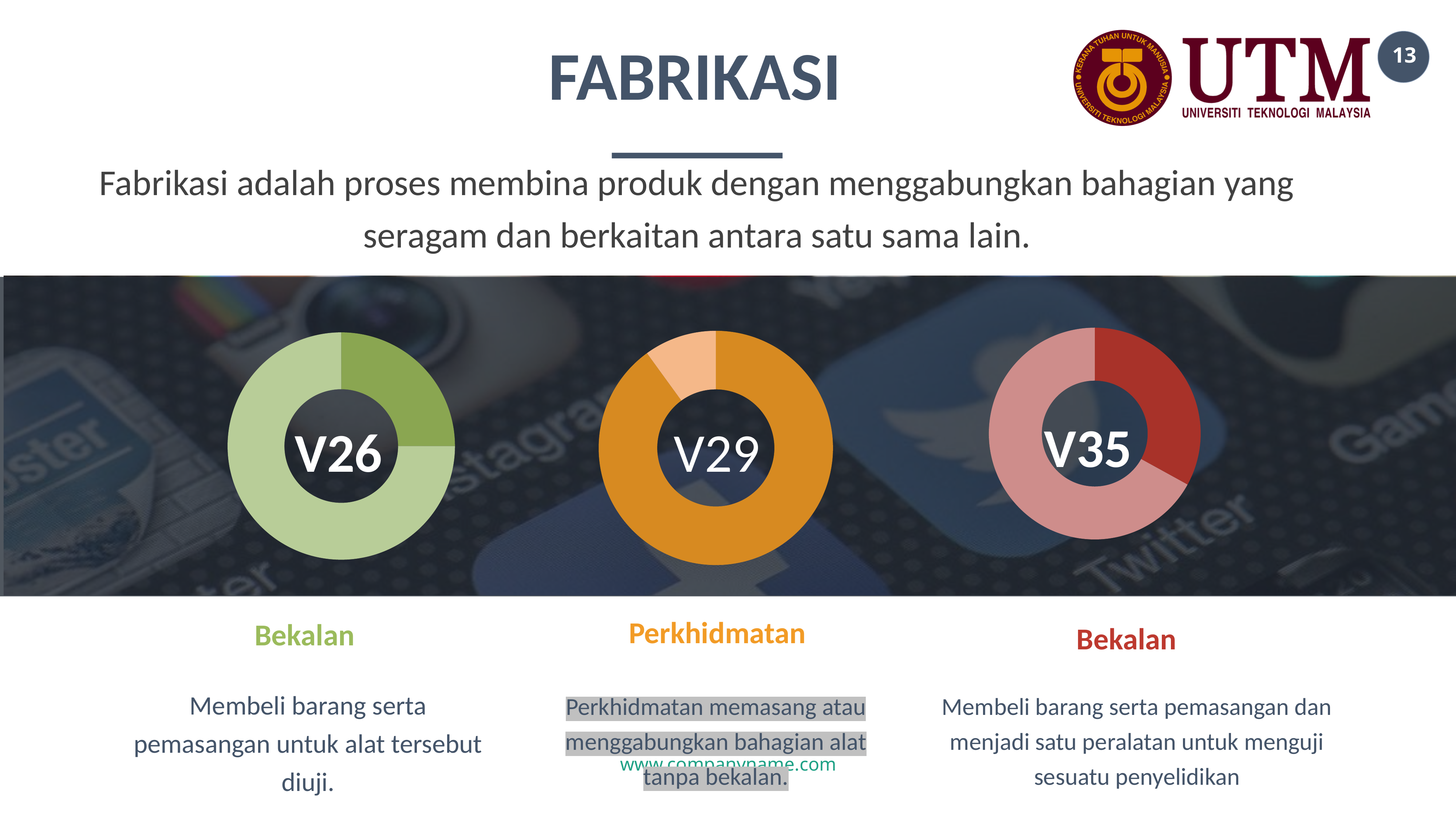
In the middle chart labelled V29, which slice is larger, the dark orange one or the light orange one? The dark orange one In the left chart labelled V26, how many slices does the donut have? 2 How many donut charts are shown on the slide? 3 What text is printed in the centre of the middle donut chart? V29 What kind of chart is the middle chart labelled V29? Donut chart What kind of chart is the left chart labelled V26? Donut chart In the left chart labelled V26, which slice is larger, the dark green one or the light green one? The light green one In the right chart labelled V35, which slice is larger, the dark red one or the light red one? The light red one In the right chart labelled V35, how many slices does the donut have? 2 What label appears below the right donut chart labelled V35? Bekalan